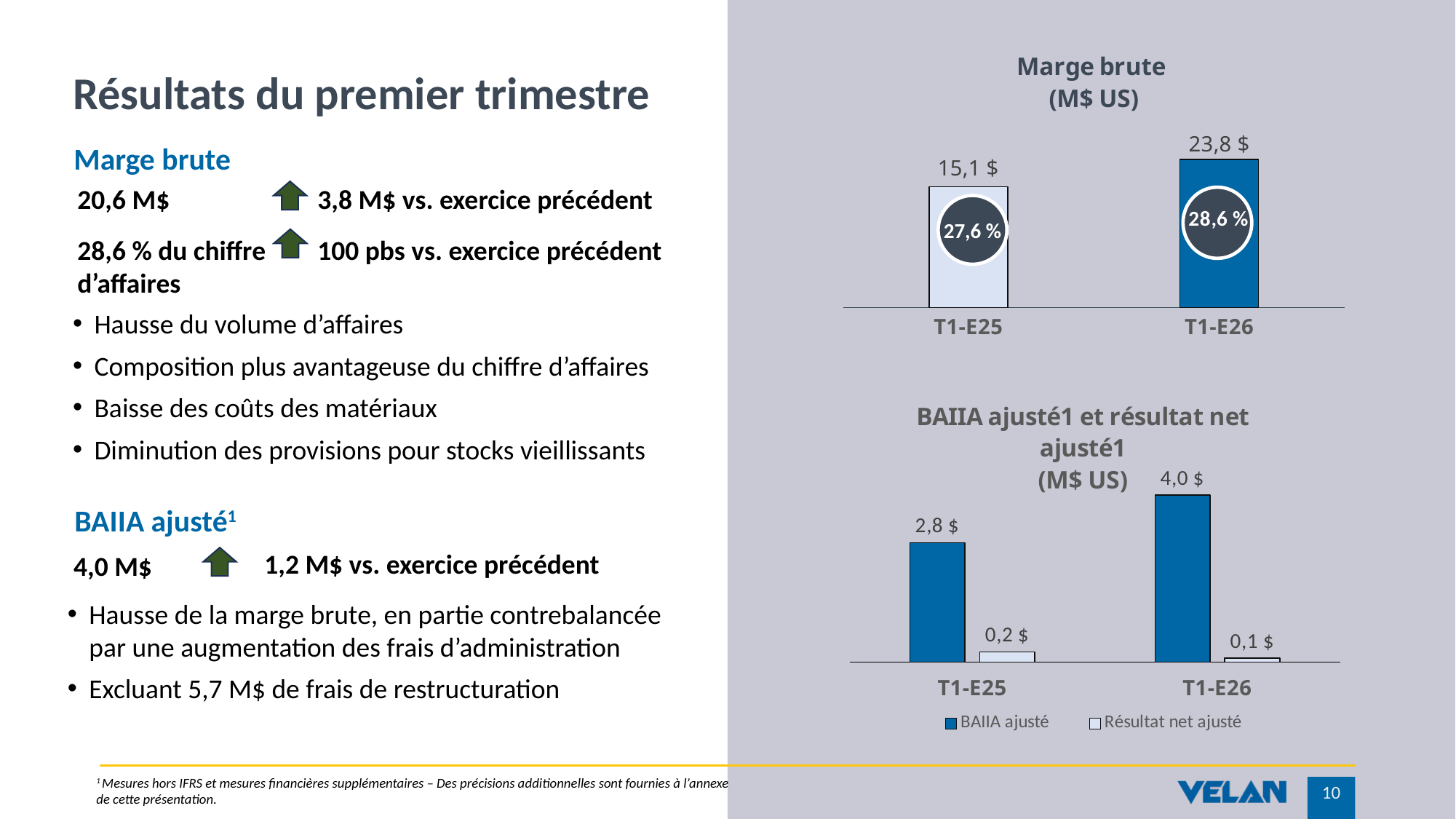
In the 'Marge brute (M$ US)' chart, which period has the higher value? T1-E26 In the 'BAIIA ajusté et résultat net ajusté (M$ US)' chart, does the Résultat net ajusté rise or fall from T1-E25 to T1-E26? fall What type of chart is the 'Marge brute (M$ US)' chart? bar chart In the 'Marge brute (M$ US)' chart, what is the difference between the T1-E26 and T1-E25 values? 8,7 $ In the 'Marge brute (M$ US)' chart, what percentage is shown inside the T1-E26 bar? 28,6 % In the 'BAIIA ajusté et résultat net ajusté (M$ US)' chart, how many series does the legend list? 2 In the 'BAIIA ajusté et résultat net ajusté (M$ US)' chart, what is the difference in BAIIA ajusté between T1-E26 and T1-E25? 1,2 $ In the 'Marge brute (M$ US)' chart, what percentage is shown inside the T1-E25 bar? 27,6 % In the 'Marge brute (M$ US)' chart, what is the value for T1-E26? 23,8 $ In the 'BAIIA ajusté et résultat net ajusté (M$ US)' chart, what is the BAIIA ajusté value for T1-E26? 4,0 $ In the 'Marge brute (M$ US)' chart, what is the value for T1-E25? 15,1 $ In the 'BAIIA ajusté et résultat net ajusté (M$ US)' chart, what is the Résultat net ajusté value for T1-E25? 0,2 $